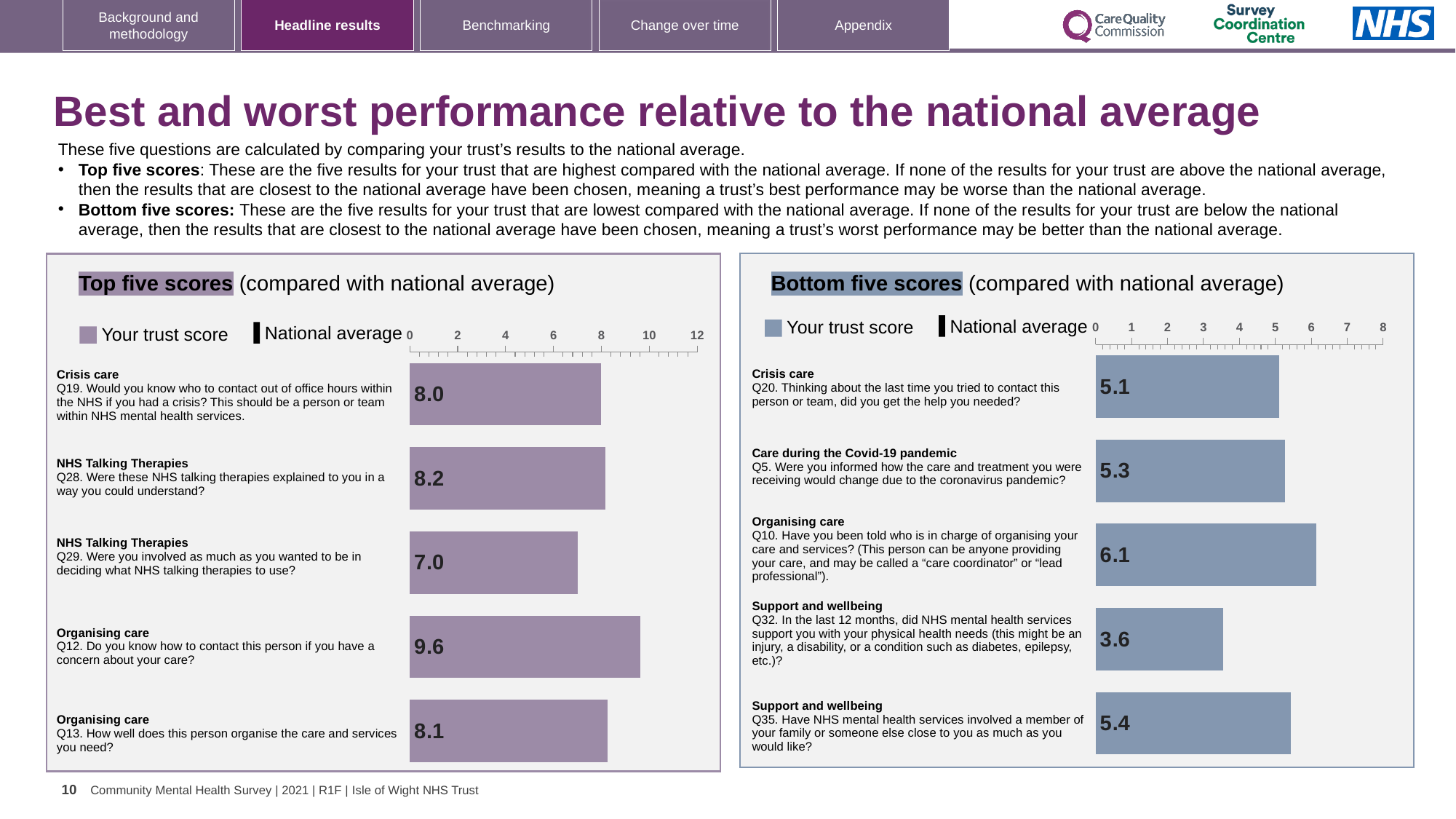
In the 'Bottom five scores' chart, which question has the lowest trust score? Q32 In the 'Bottom five scores' chart, which question has the highest trust score? Q10 In the 'Bottom five scores' chart, what is the difference between the trust scores for Q35 and Q32? 1.8 In the 'Top five scores' chart, what is the trust score for Q12 (Do you know how to contact this person if you have a concern about your care?)? 9.6 In the 'Bottom five scores' chart, is the trust score for Q5 larger than the trust score for Q20? Yes In the 'Top five scores' chart, what is the difference between the trust scores for Q12 and Q29? 2.6 In the 'Top five scores' chart, which question has the highest trust score? Q12 In the 'Top five scores' chart, which question has the lowest trust score? Q29 In the 'Bottom five scores' chart, what is the trust score for Q10 (Have you been told who is in charge of organising your care and services?)? 6.1 How many entries does the legend of the 'Bottom five scores' chart list? 2 In the 'Top five scores' chart, how many questions are plotted? 5 What kind of chart is the 'Top five scores' chart? Bar chart